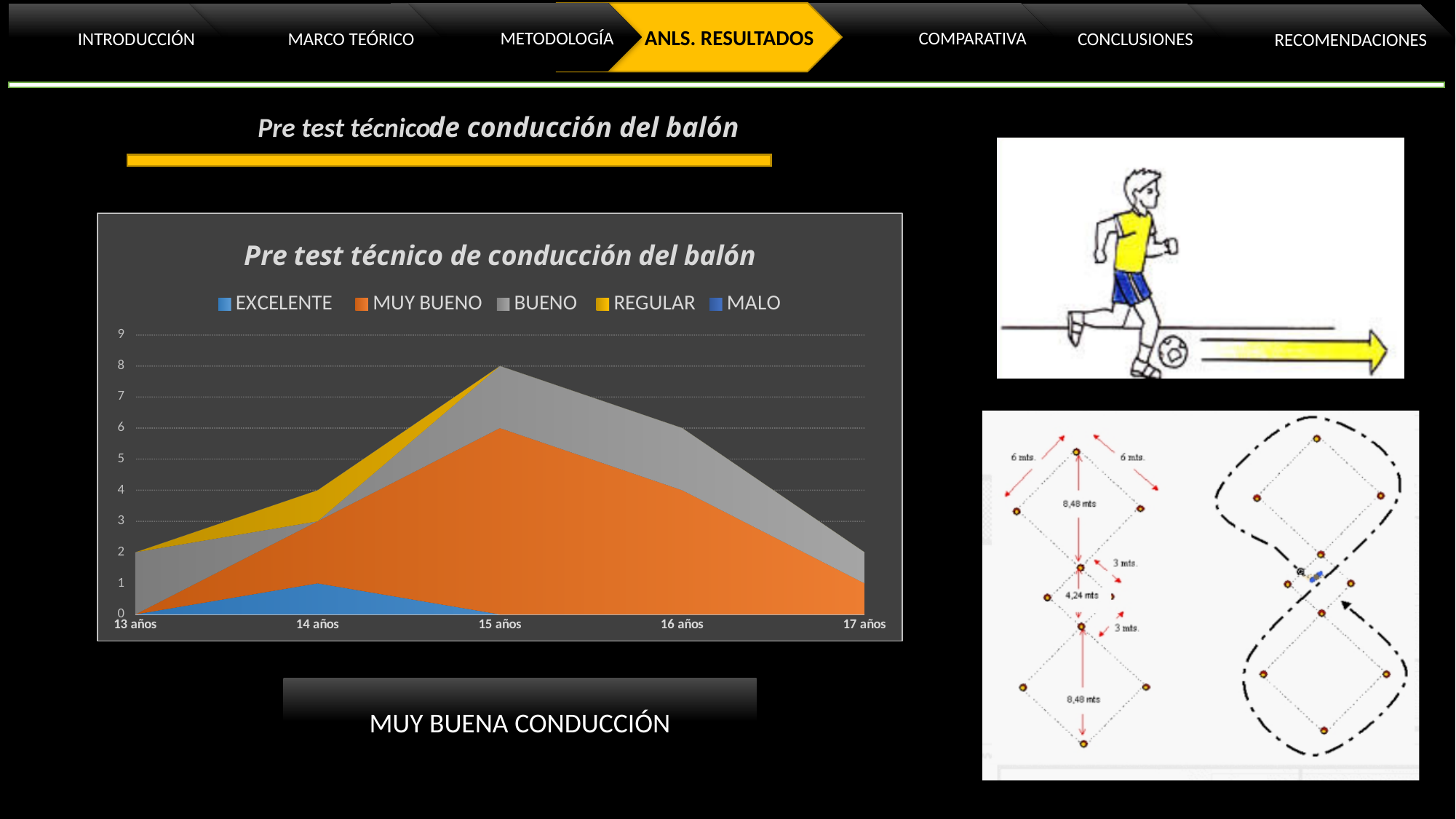
What is the value of the BUENO series at 15 años? 2 How many age categories are shown on the x axis? 5 How many series does the chart legend list? 5 What is the title of the chart? Pre test técnico de conducción del balón What kind of chart is shown on the slide? area chart Is the value of the EXCELENTE series at 15 años greater or less than 1? less Does the MUY BUENO series rise or fall from 15 años to 17 años? fall Which colour represents the MUY BUENO series in the chart? orange At which age category does the MUY BUENO series reach its highest value? 15 años What is the value of the MUY BUENO series at 15 años? 6 Is the value of the BUENO series at 16 años greater or less than 5? less At 16 años, which series has the larger value, BUENO or MUY BUENO? MUY BUENO